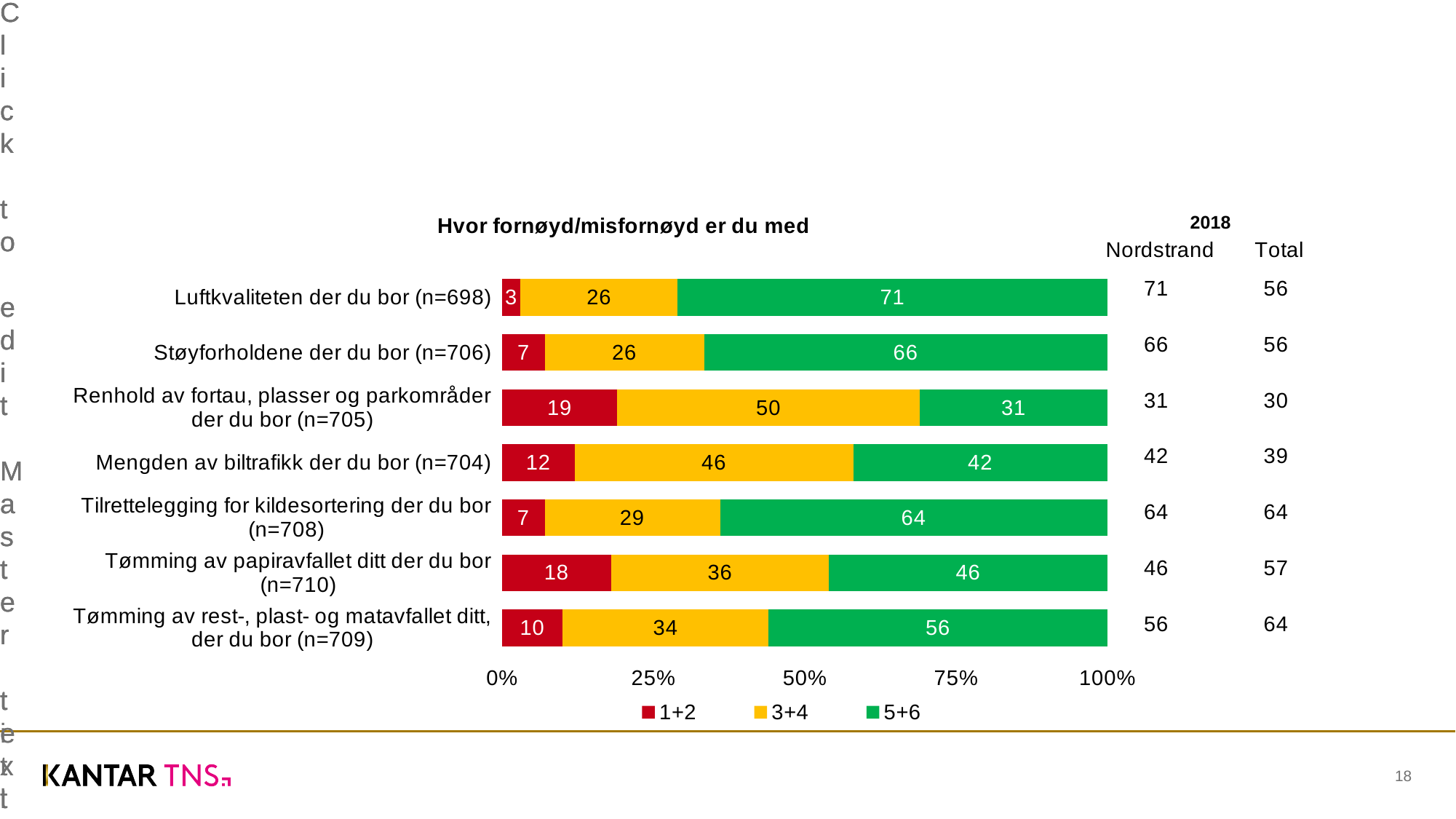
How many categories are shown in the chart? 7 What is the difference between the 3+4 value for "Renhold av fortau, plasser og parkområder der du bor (n=705)" and the 3+4 value for "Luftkvaliteten der du bor (n=698)"? 24 What is the value of the 1+2 series for "Renhold av fortau, plasser og parkområder der du bor (n=705)"? 19 How many series does the legend list? 3 What is the total of the stacked bar for "Luftkvaliteten der du bor (n=698)"? 100 What is the value of the 5+6 series for "Luftkvaliteten der du bor (n=698)"? 71 What is the title of the chart? Hvor fornøyd/misfornøyd er du med What kind of chart is shown on the slide? Stacked bar chart Which has a larger 1+2 value: "Tømming av papiravfallet ditt der du bor (n=710)" or "Mengden av biltrafikk der du bor (n=704)"? Tømming av papiravfallet ditt der du bor (n=710) Which category has the highest value for the 5+6 series? Luftkvaliteten der du bor (n=698) What is the value of the 3+4 series for "Tømming av rest-, plast- og matavfallet ditt, der du bor (n=709)"? 34 Which category has the lowest value for the 5+6 series? Renhold av fortau, plasser og parkområder der du bor (n=705)